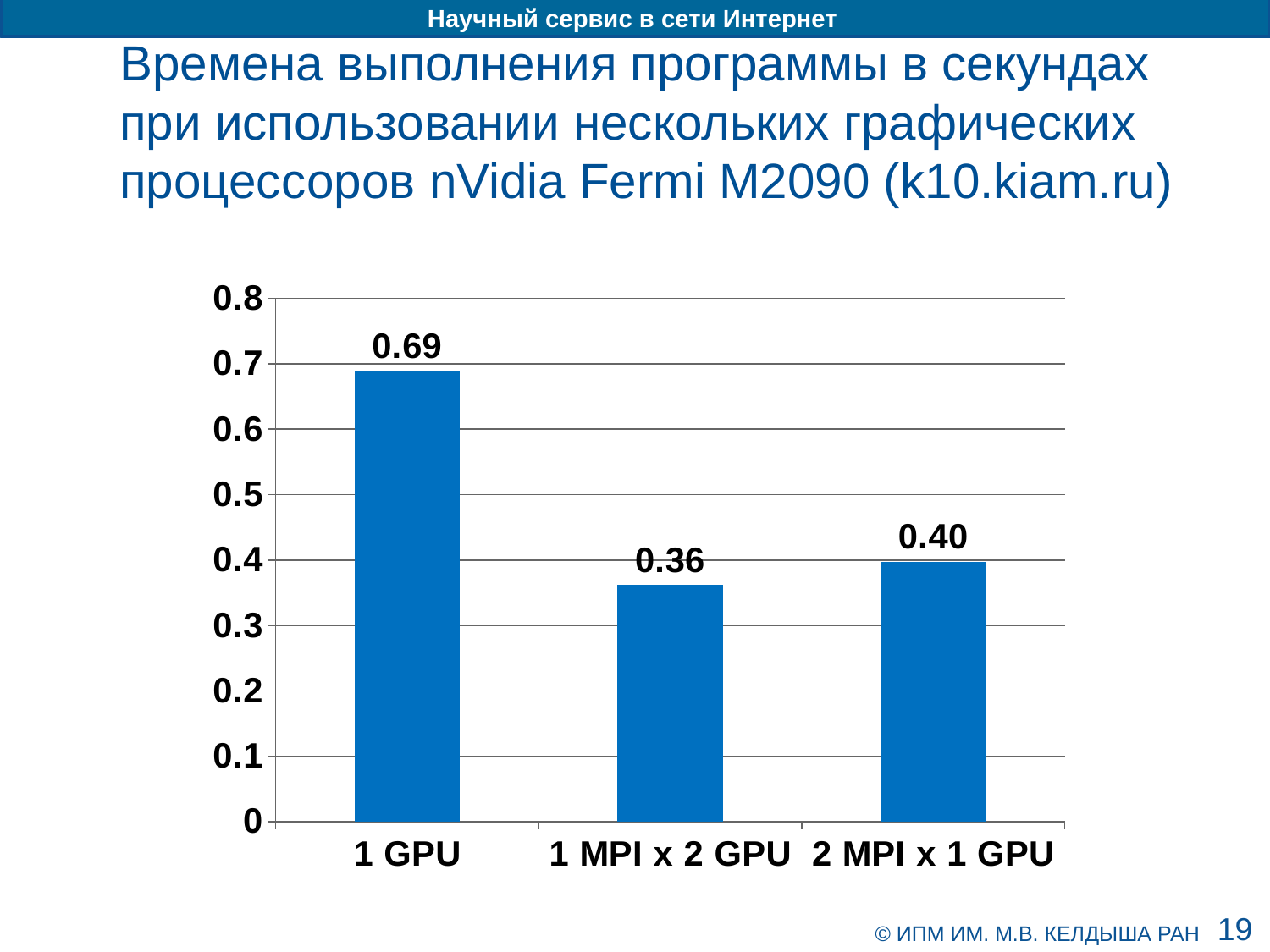
Which category has the highest value? 1 GPU Is the value for 1 GPU greater or less than 0.6? greater What is the value for 1 MPI x 2 GPU? 0.36 Which is larger, the value for 1 GPU or the value for 2 MPI x 1 GPU? 1 GPU What is the difference between the values for 2 MPI x 1 GPU and 1 MPI x 2 GPU? 0.04 What kind of chart is shown on the slide? bar chart What is the value for 2 MPI x 1 GPU? 0.40 Which category has the lowest value? 1 MPI x 2 GPU How many categories are shown on the x axis? 3 What is the value for 1 GPU? 0.69 What is the maximum value shown on the y axis? 0.8 What is the difference between the values for 1 GPU and 1 MPI x 2 GPU? 0.33